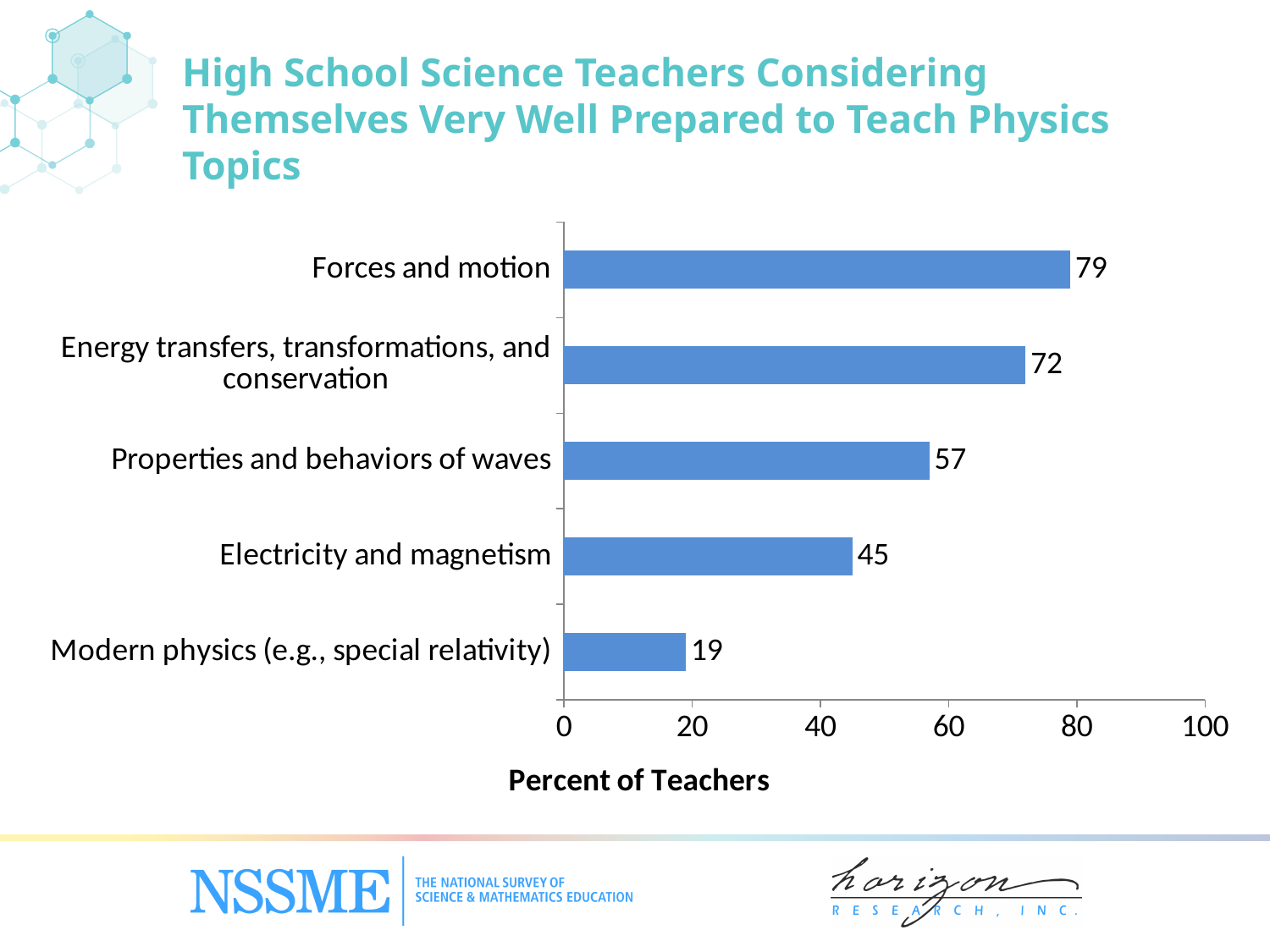
What is the difference between the values for Forces and motion and Properties and behaviors of waves? 22 What is the value for Modern physics (e.g., special relativity)? 19 What is the label of the horizontal axis? Percent of Teachers What percent of teachers consider themselves very well prepared to teach Forces and motion? 79 What kind of chart is shown on the slide? bar chart Which topic has the lowest percent of teachers? Modern physics (e.g., special relativity) Is the value for Properties and behaviors of waves greater or less than 60? less What is the difference between the values for Electricity and magnetism and Modern physics (e.g., special relativity)? 26 Which is larger: the value for Energy transfers, transformations, and conservation or the value for Electricity and magnetism? Energy transfers, transformations, and conservation What is the value for Electricity and magnetism? 45 Which topic has the highest percent of teachers? Forces and motion How many topics are shown in the chart? 5